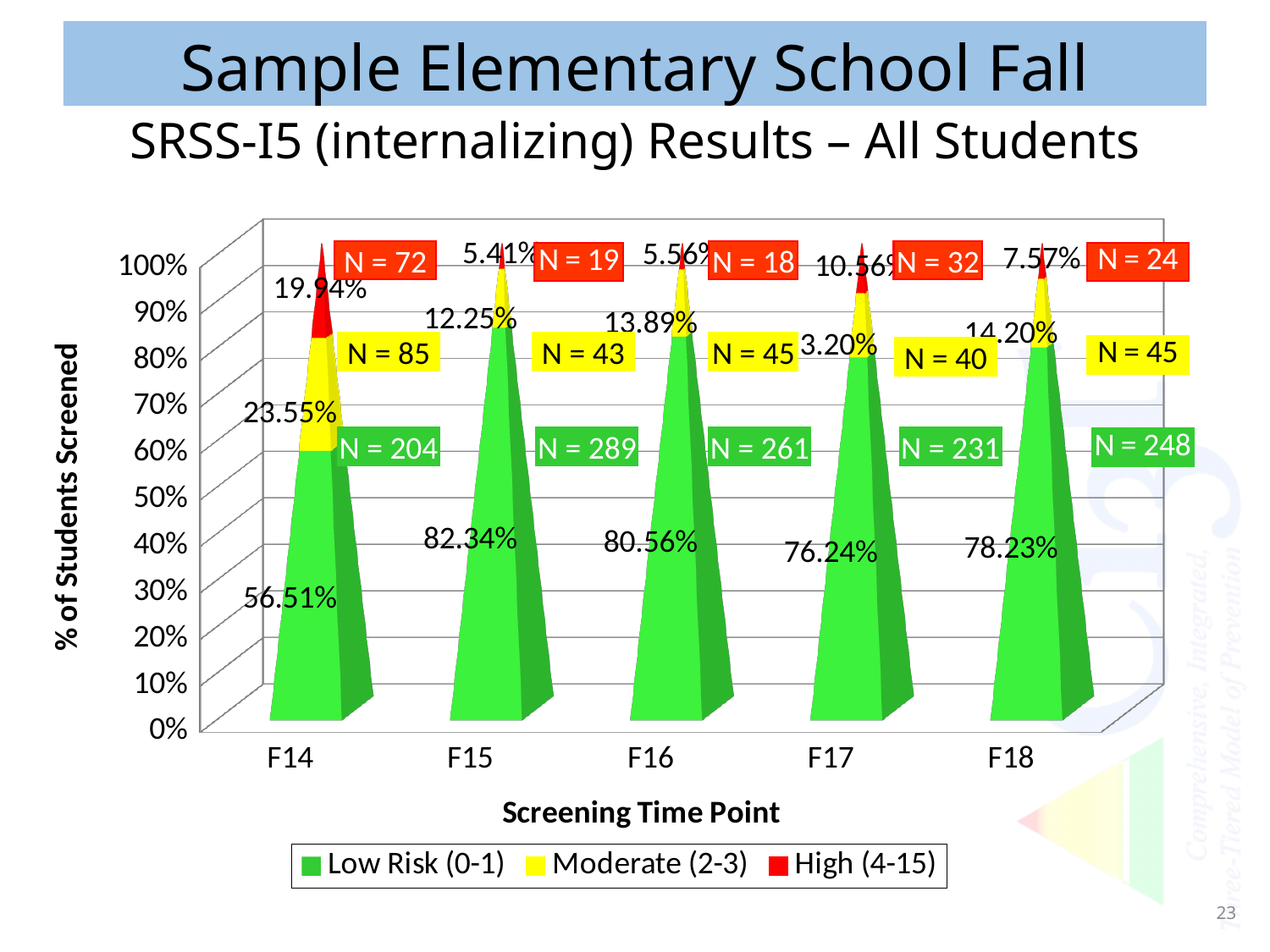
Which screening time point has the highest Low Risk (0-1) percentage? F15 How many screening time points are shown on the x axis? 5 What is the Low Risk (0-1) percentage for F15? 82.34% What is the High (4-15) percentage for F18? 7.57% What is the difference between the Low Risk (0-1) percentages for F15 and F14? 25.83% Which screening time point has the lowest Low Risk (0-1) percentage? F14 How many series does the legend list? 3 Is the High (4-15) percentage larger for F14 or for F16? F14 What is the Moderate (2-3) percentage for F16? 13.89% What is the N value shown for the Low Risk (0-1) group at F16? N = 261 What is the label of the y axis? % of Students Screened What is the Low Risk (0-1) percentage for F14? 56.51%